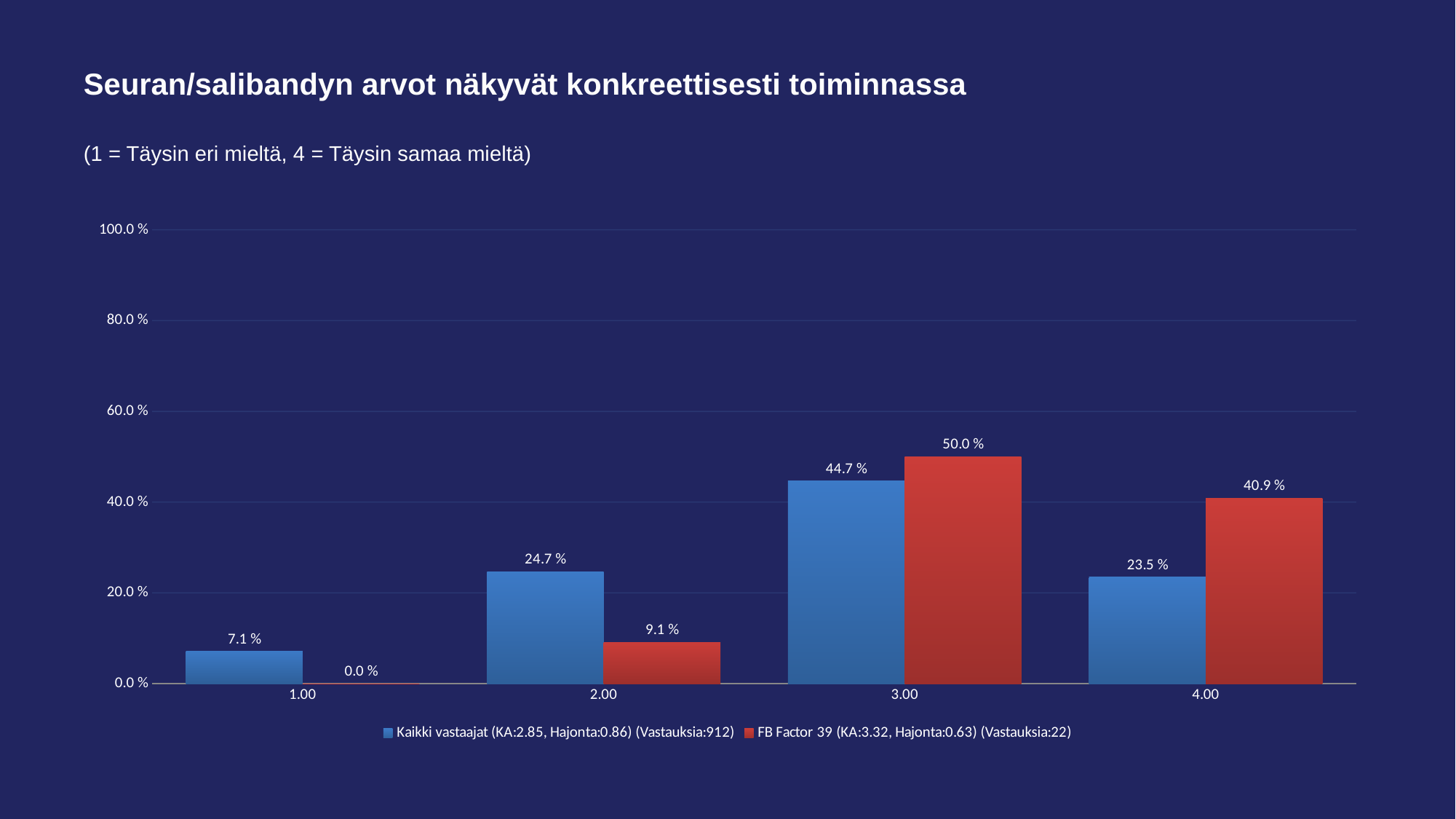
Which category has the lowest value for Kaikki vastaajat? 1.00 How many series does the legend list? 2 At category 2.00, which series has the larger value, Kaikki vastaajat or FB Factor 39? Kaikki vastaajat What is the value for FB Factor 39 at category 4.00? 40.9 % How many categories are shown on the x axis? 4 What kind of chart is shown on the slide? Bar chart What is the value for Kaikki vastaajat at category 3.00? 44.7 % What colour are the bars for the FB Factor 39 series? Red Which category has the highest value for FB Factor 39? 3.00 What is the value for Kaikki vastaajat at category 2.00? 24.7 % What is the value for FB Factor 39 at category 1.00? 0.0 % What is the difference between the FB Factor 39 and Kaikki vastaajat values at category 4.00? 17.4 %